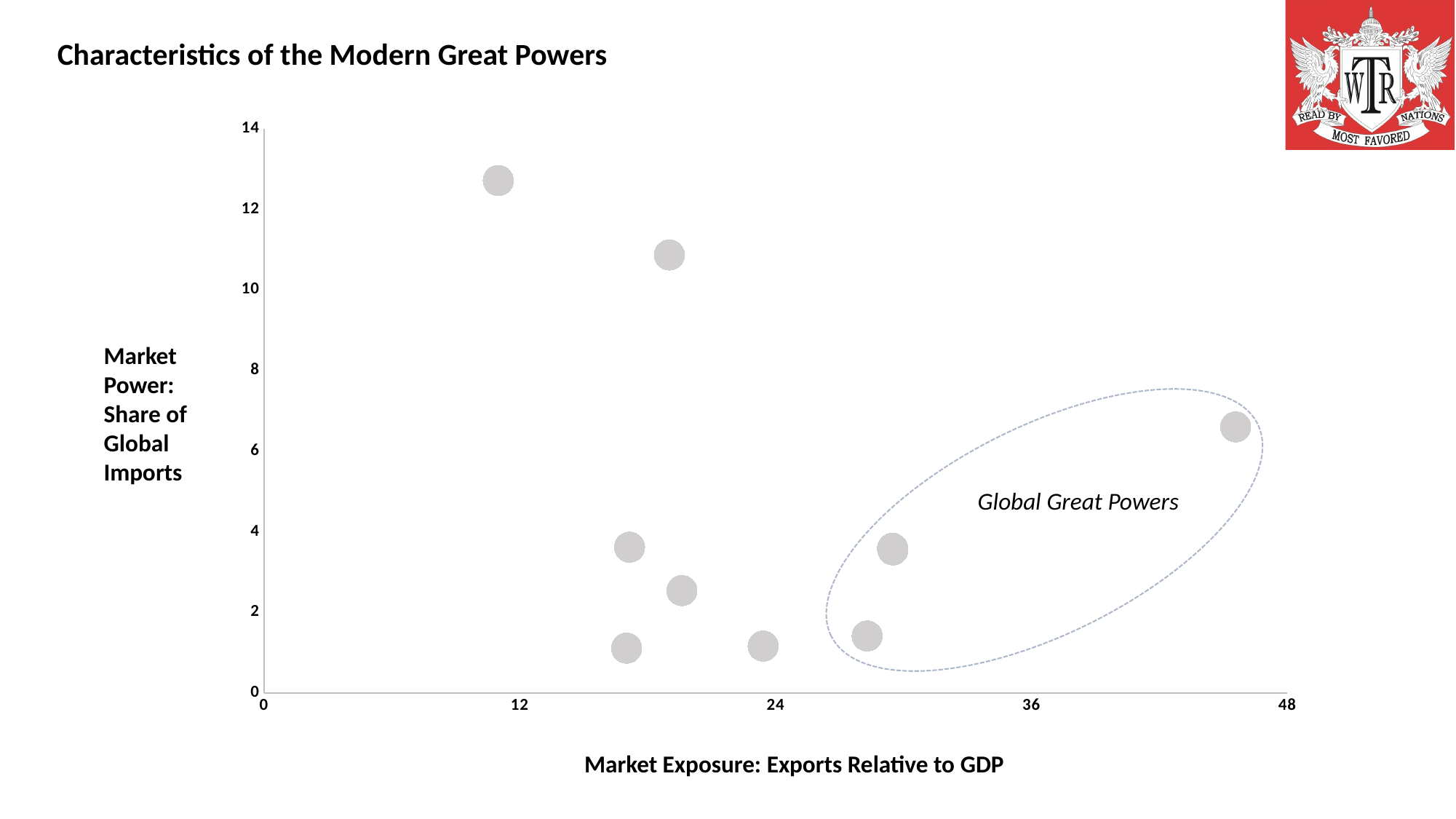
What is the title of the x axis of the chart? Market Exposure: Exports Relative to GDP What kind of chart is shown on the slide? scatter plot How many data points have a share of global imports below 2? 3 Is the exports-relative-to-GDP value for the rightmost point on the chart greater or less than 36? greater How many data points have a share of global imports above 10? 2 Is the share of global imports for the rightmost point on the chart greater or less than 8? less What label is written inside the dashed ellipse on the chart? Global Great Powers Is the share of global imports for the highest point on the chart greater or less than 12? greater